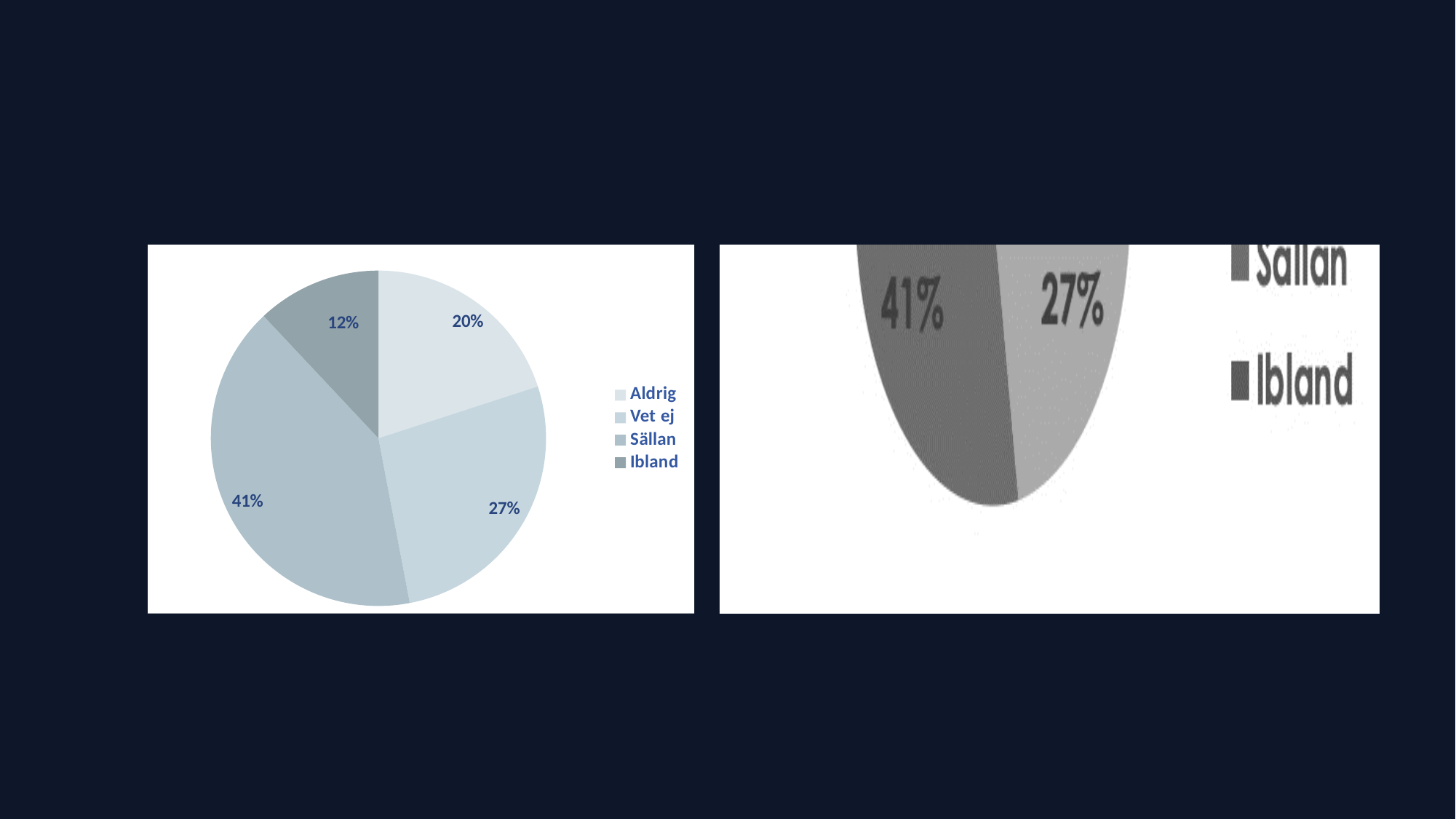
In the pie chart on the left, what is the difference in percentage points between the Sällan and Vet ej slices? 14 In the pie chart on the left, what share does the Aldrig slice have? 20% In the pie chart on the left, which category has the smallest slice? Ibland In the pie chart on the left, what share does the Ibland slice have? 12% In the pie chart on the left, which category has the largest slice? Sällan In the pie chart on the left, what share does the Sällan slice have? 41% In the pie chart on the left, what share does the Vet ej slice have? 27% In the cropped chart image on the right, which two percentage labels are visible? 41% and 27% In the pie chart on the left, what are the four legend entries? Aldrig, Vet ej, Sällan, Ibland In the pie chart on the left, which slice is larger, Aldrig or Vet ej? Vet ej What type of chart is shown on the left of the slide? Pie chart How many slices does the pie chart on the left have? 4